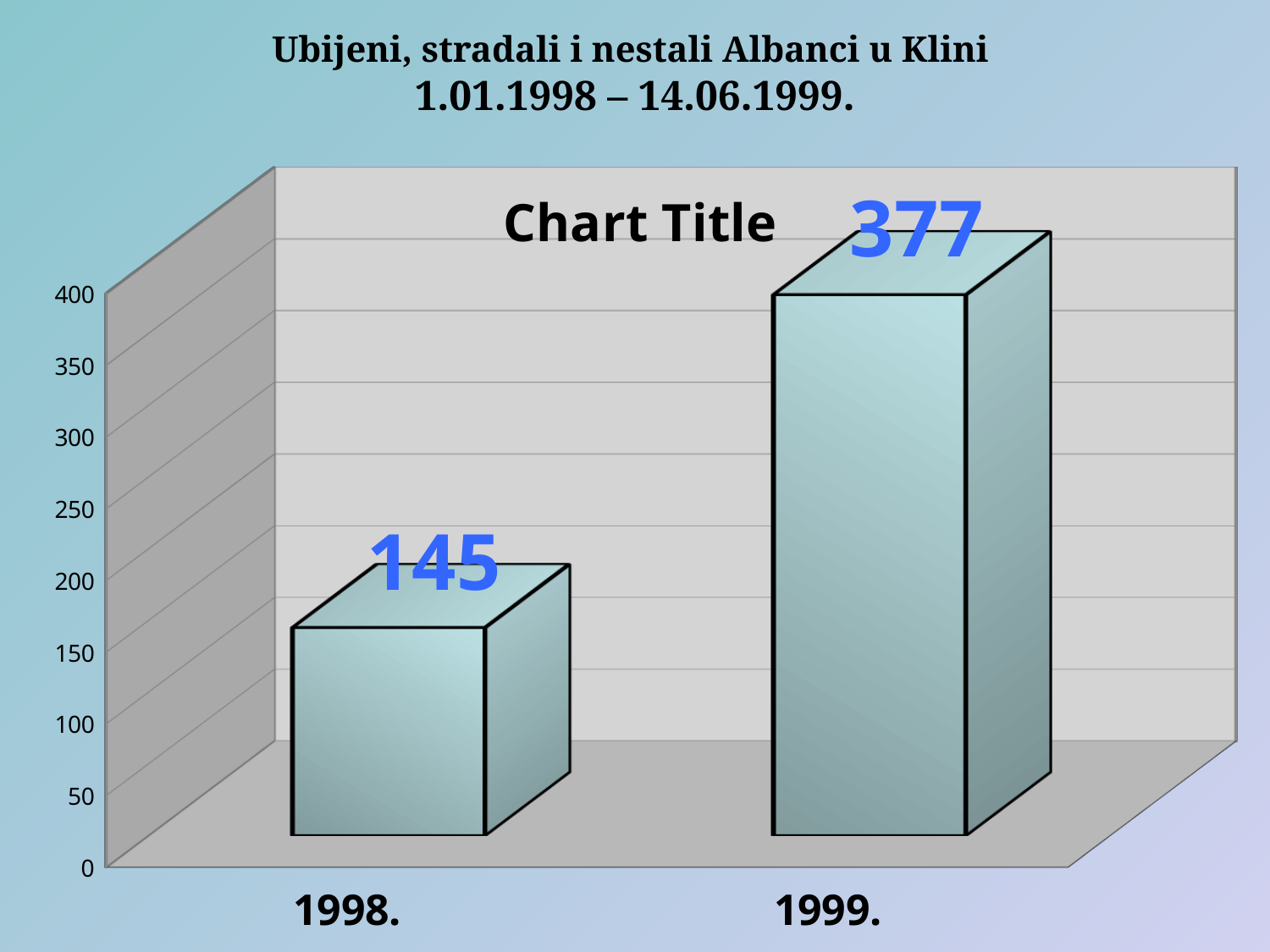
Do the values rise or fall from 1998. to 1999.? rise What is the title printed inside the chart area? Chart Title Which is larger, the value for 1998. or the value for 1999.? 1999. What is the difference between the values for 1999. and 1998.? 232 Is the value for 1998. greater or less than 200? less Is the value for 1999. greater or less than 350? greater What is the value for 1998.? 145 What kind of chart is shown on the slide? bar chart Which category has the highest value? 1999. Which category has the lowest value? 1998. What is the value for 1999.? 377 How many categories are shown on the x axis? 2